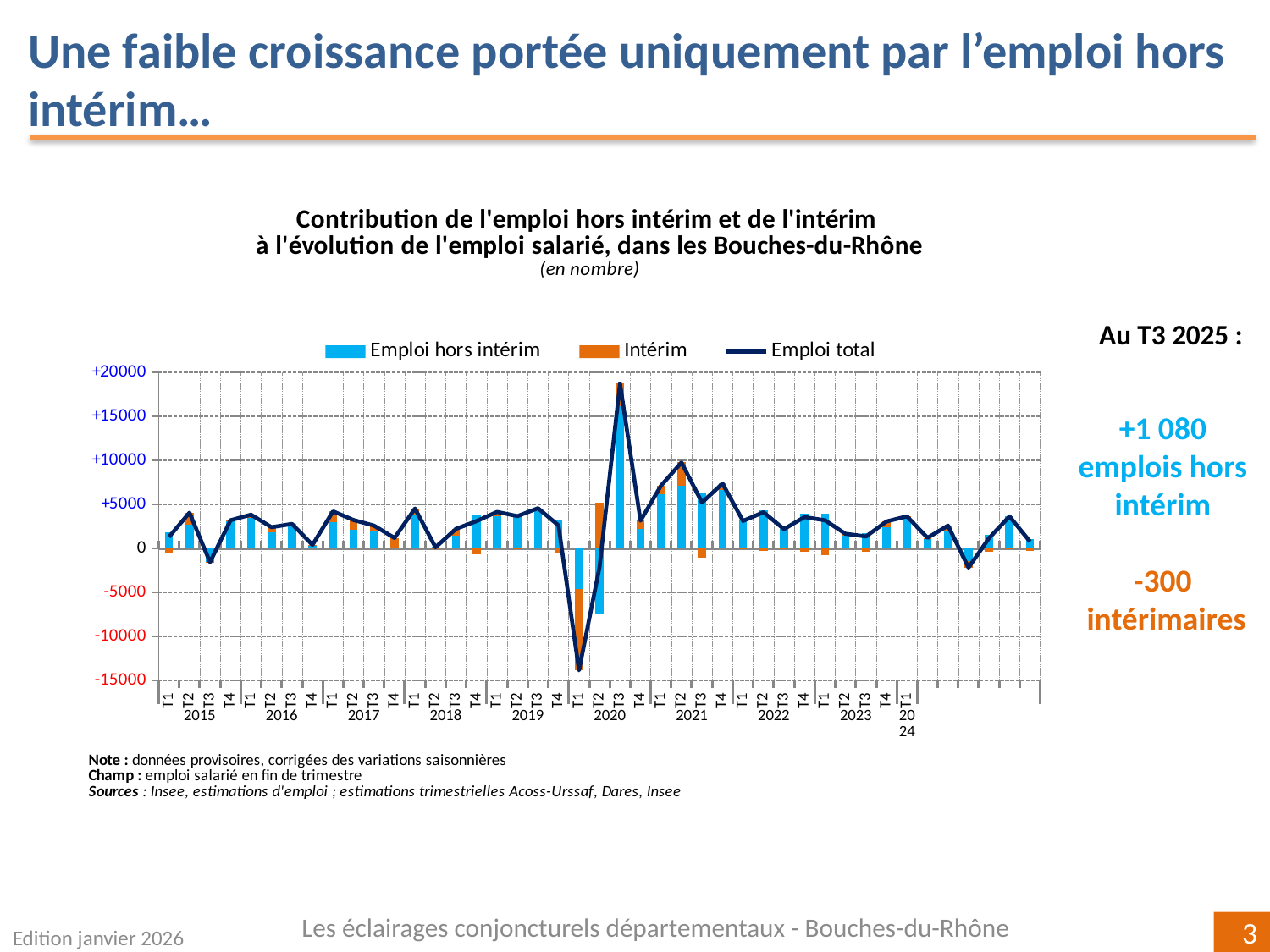
In which quarter does the Emploi total line reach its lowest value? T1 2020 Is the Emploi hors intérim value for T2 2020 greater or less than -5000? less Is the Emploi total value for T3 2020 greater or less than +15000? greater In which quarter does the Emploi total line reach its highest value? T3 2020 Which is larger, the Emploi total value for T3 2020 or for T2 2021? T3 2020 Which series is drawn as a line rather than bars? Emploi total Is the Emploi total value for T2 2021 greater or less than +5000? greater What colour are the Intérim bars? Orange How many series does the legend list? 3 What kind of chart is shown on the slide? A combined bar and line chart Does the Emploi total line rise or fall between T3 2020 and T4 2020? Fall